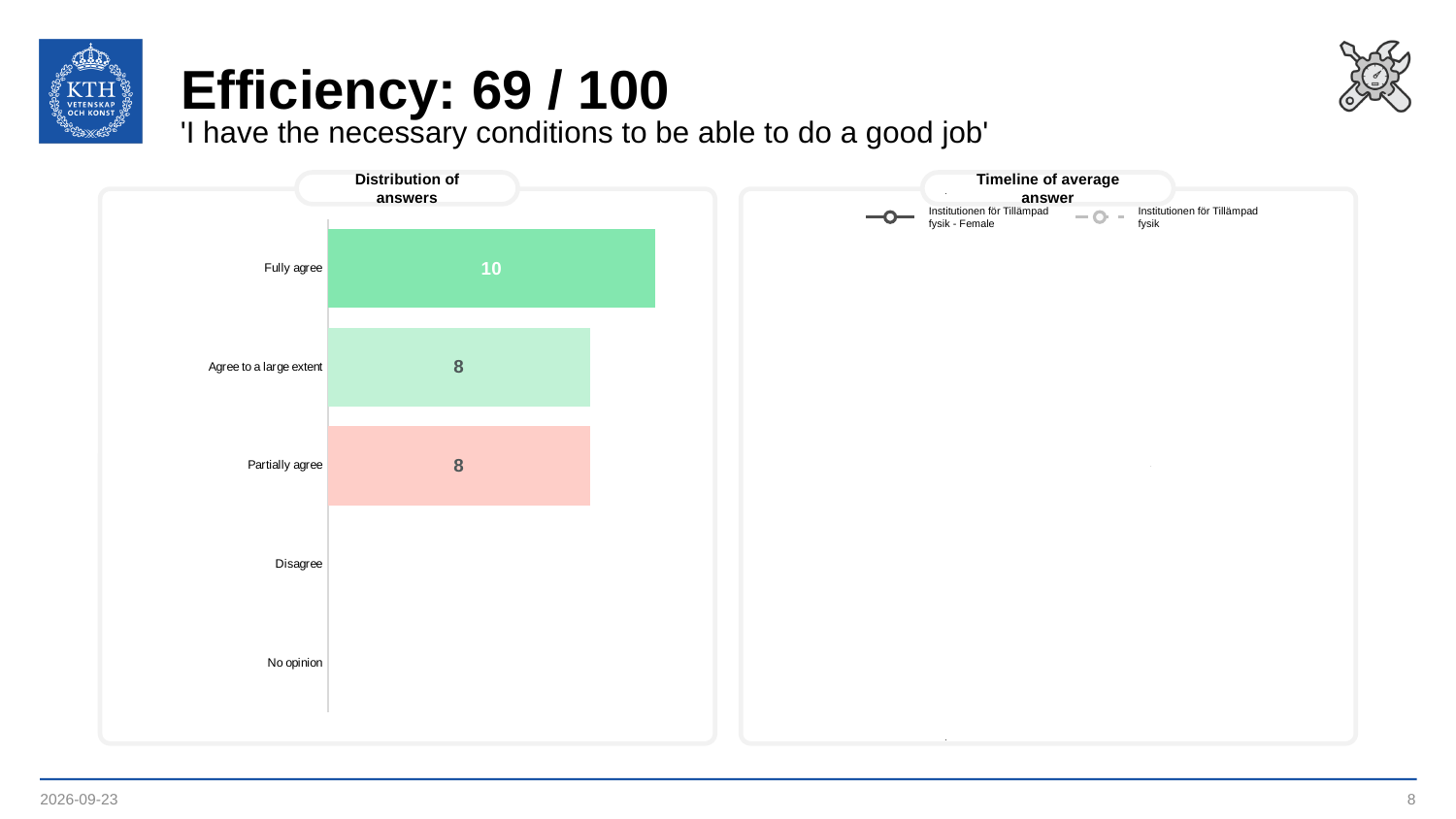
In the 'Distribution of answers' chart, which is larger: the value for 'Fully agree' or the value for 'Agree to a large extent'? Fully agree What is the title of the chart on the right side of the slide? Timeline of average answer What kind of chart is the 'Distribution of answers' chart? Bar chart In the 'Distribution of answers' chart, what is the total of the values shown for 'Fully agree', 'Agree to a large extent' and 'Partially agree'? 26 In the 'Distribution of answers' chart, what is the difference between the values for 'Fully agree' and 'Partially agree'? 2 In the 'Distribution of answers' chart, what is the value for 'Agree to a large extent'? 8 How many series does the legend of the 'Timeline of average answer' chart list? 2 In the 'Distribution of answers' chart, what is the value for 'Fully agree'? 10 In the 'Distribution of answers' chart, which categories have no bar shown? Disagree and No opinion In the 'Distribution of answers' chart, which category has the highest value? Fully agree How many categories are listed on the axis of the 'Distribution of answers' chart? 5 In the 'Distribution of answers' chart, what is the value for 'Partially agree'? 8